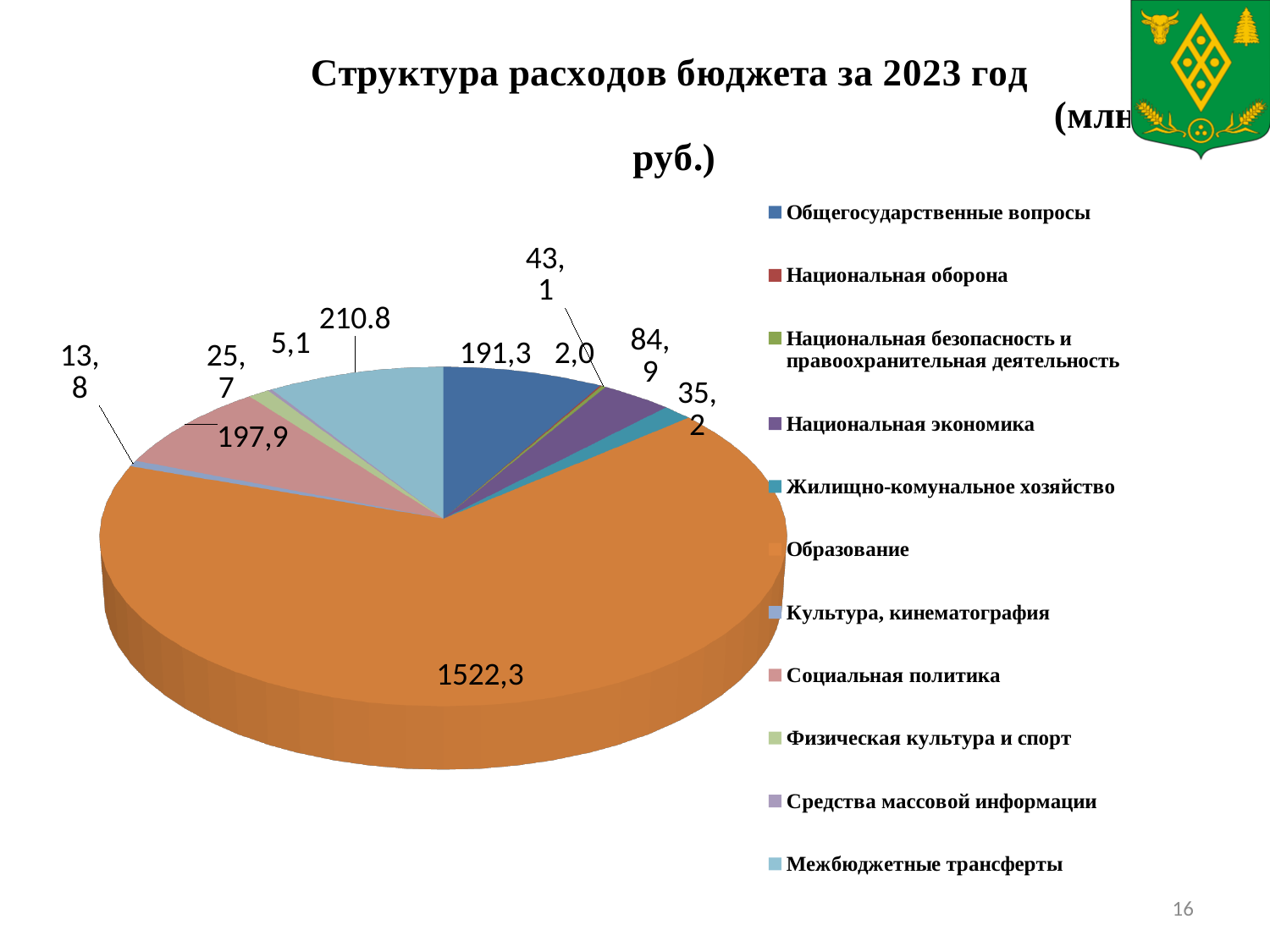
What is the title of the chart? Структура расходов бюджета за 2023 год (млн руб.) What is the value for Образование? 1522,3 Which category has the largest slice of the pie? Образование How many categories does the legend list? 11 What is the difference between Социальная политика and Общегосударственные вопросы? 6,6 What kind of chart is shown on the slide? pie chart What is the value for Социальная политика? 197,9 What is the smallest value labelled on the pie chart? 2,0 What is the value for Межбюджетные трансферты? 210.8 What is the value for Национальная экономика? 84,9 What is the value for Общегосударственные вопросы? 191,3 Which is larger, Межбюджетные трансферты or Социальная политика? Межбюджетные трансферты